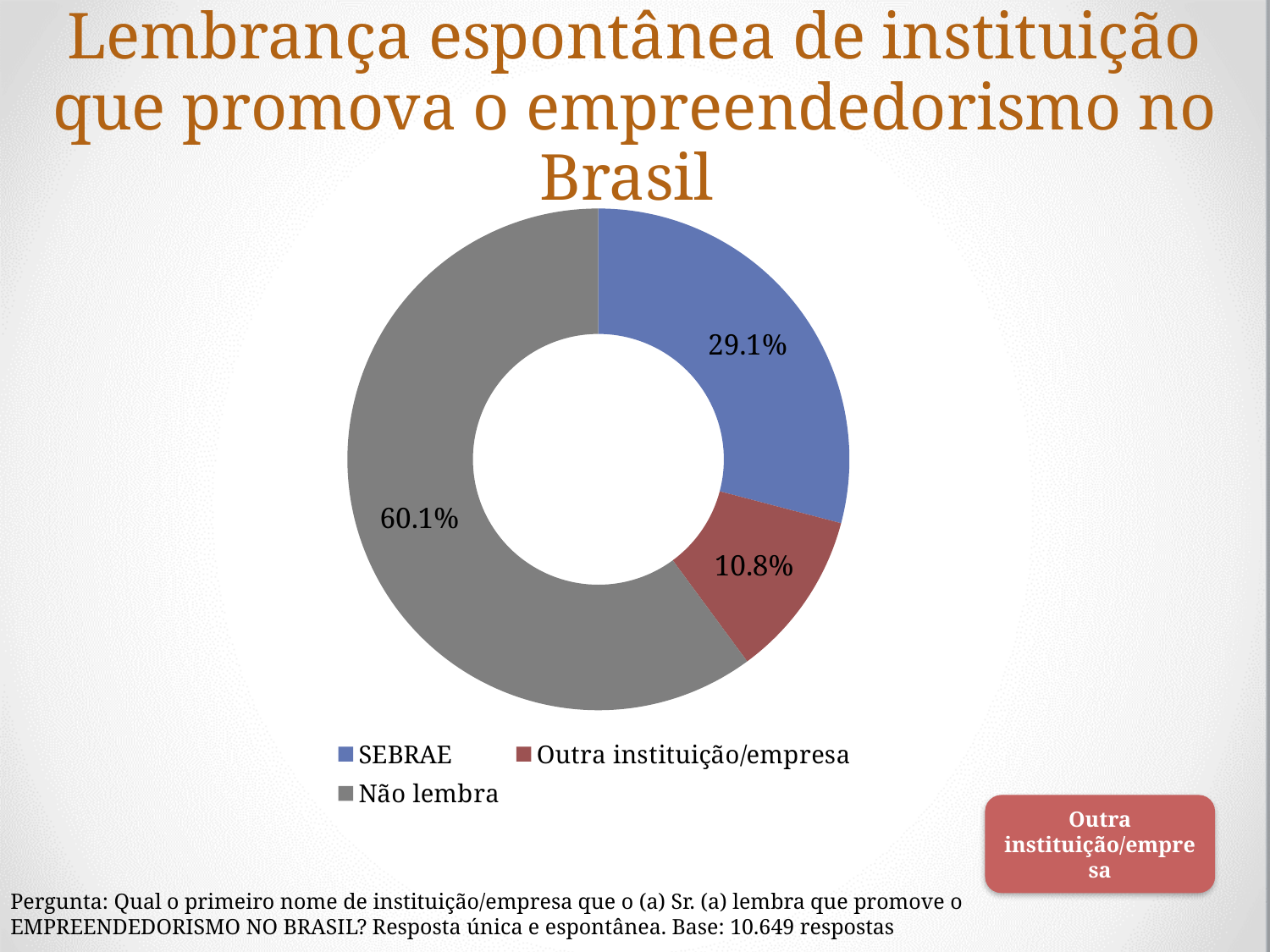
Which is larger, the share for SEBRAE or the share for Outra instituição/empresa? SEBRAE What percentage of respondents recalled another institution/company (Outra instituição/empresa)? 10.8% How many categories are shown in the pie chart? 3 Which category has the smallest share of the pie? Outra instituição/empresa What type of chart is shown on the slide? Pie chart (doughnut) What percentage of respondents did not remember any institution (Não lembra)? 60.1% What percentage of respondents spontaneously recalled SEBRAE? 29.1% What is the base (number of responses) stated at the bottom of the slide? 10.649 respostas Which category has the largest share of the pie? Não lembra What colour represents the Não lembra category in the chart? Grey What is the difference in percentage points between Não lembra and SEBRAE? 31.0 percentage points What is the difference in percentage points between SEBRAE and Outra instituição/empresa? 18.3 percentage points